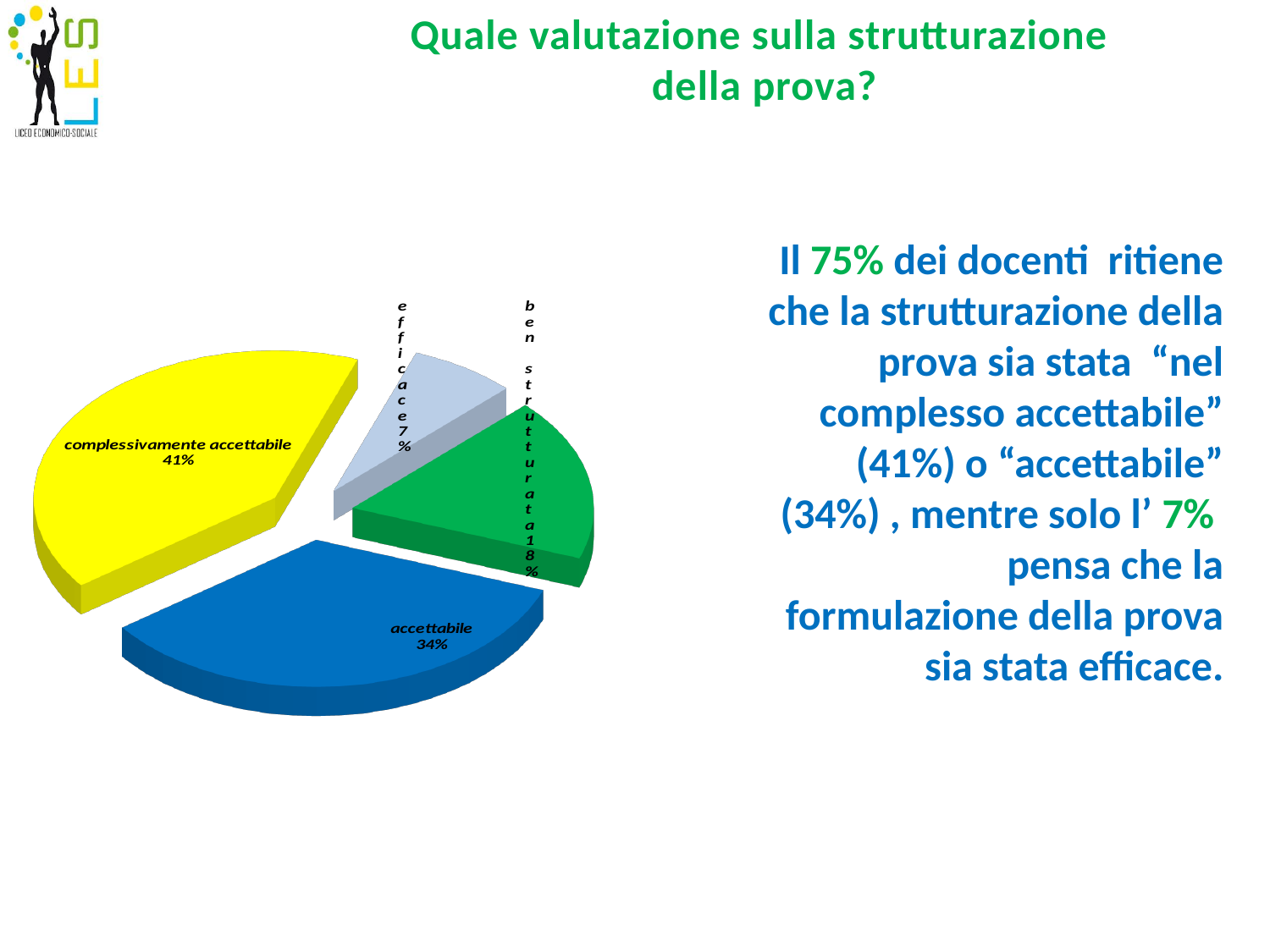
What percentage is shown for "ben strutturata"? 18% Which category has the smallest share of the pie? efficace How many slices does the pie chart have? 4 What is the difference in percentage points between "complessivamente accettabile" and "accettabile"? 7 What is the combined share of "complessivamente accettabile" and "accettabile"? 75% Which category has the largest share of the pie? complessivamente accettabile What percentage is shown for "accettabile"? 34% What kind of chart is shown on the slide? pie chart What colour is the "accettabile" slice? blue What percentage is shown for "complessivamente accettabile"? 41% What percentage is shown for "efficace"? 7% Which is larger, the share for "ben strutturata" or the share for "efficace"? ben strutturata